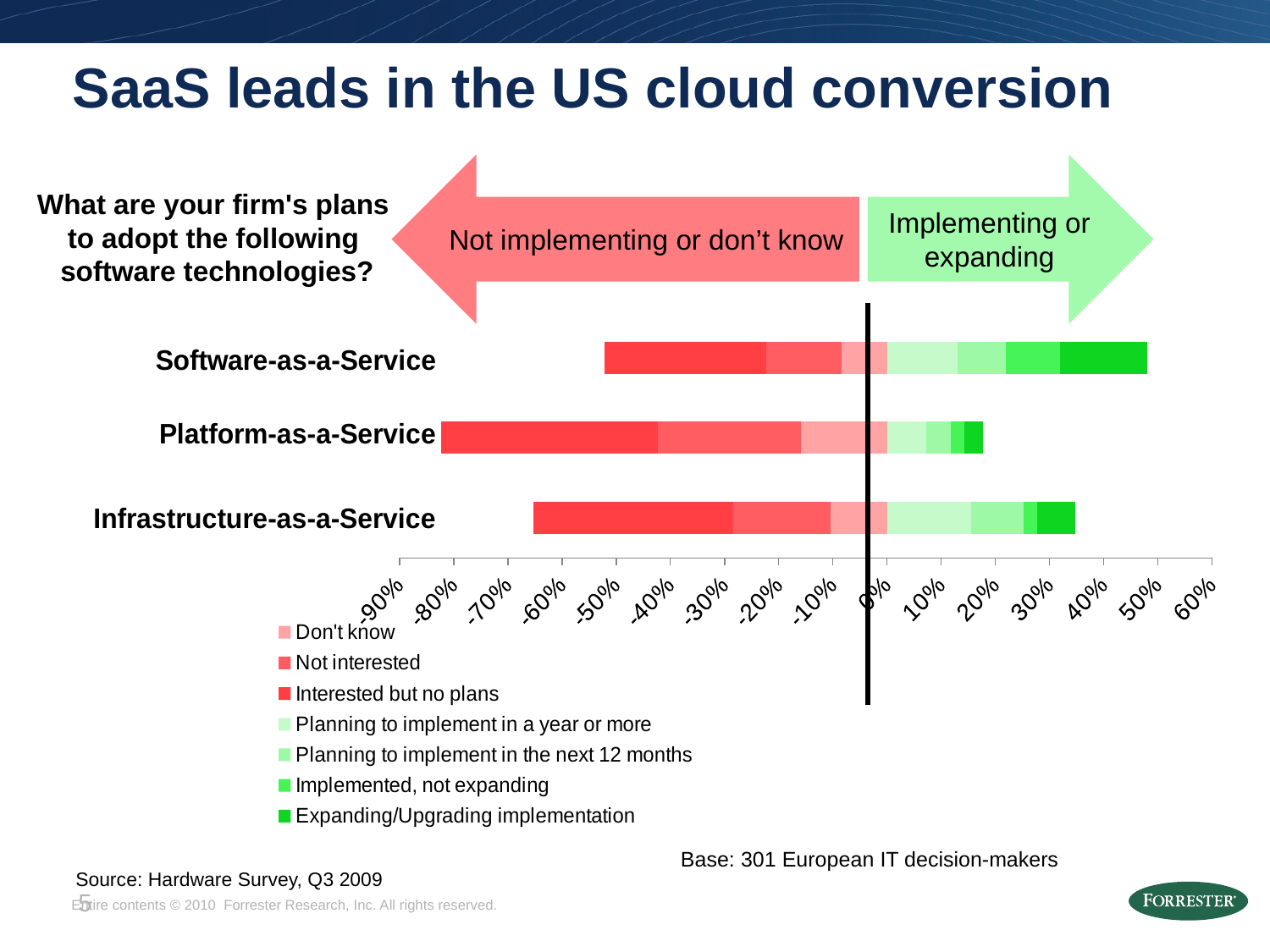
How many software technologies (categories) are plotted in the chart? 3 Is the total implementing or expanding share for Infrastructure-as-a-Service greater or less than 20%? greater Which technology has the shortest green (implementing or expanding) portion of its bar? Platform-as-a-Service Is the total implementing or expanding share for Software-as-a-Service greater or less than 40%? greater Which technology has the longest red (not implementing or don't know) portion of its bar? Platform-as-a-Service Does the red portion of the Platform-as-a-Service bar extend beyond -70% on the axis? Yes Which is larger: the green portion for Infrastructure-as-a-Service or the green portion for Platform-as-a-Service? Infrastructure-as-a-Service How many series does the chart legend list? 7 What is the first entry listed in the chart legend? Don't know What kind of chart is shown on the slide? Stacked bar chart Which technology has the longest green (implementing or expanding) portion of its bar? Software-as-a-Service